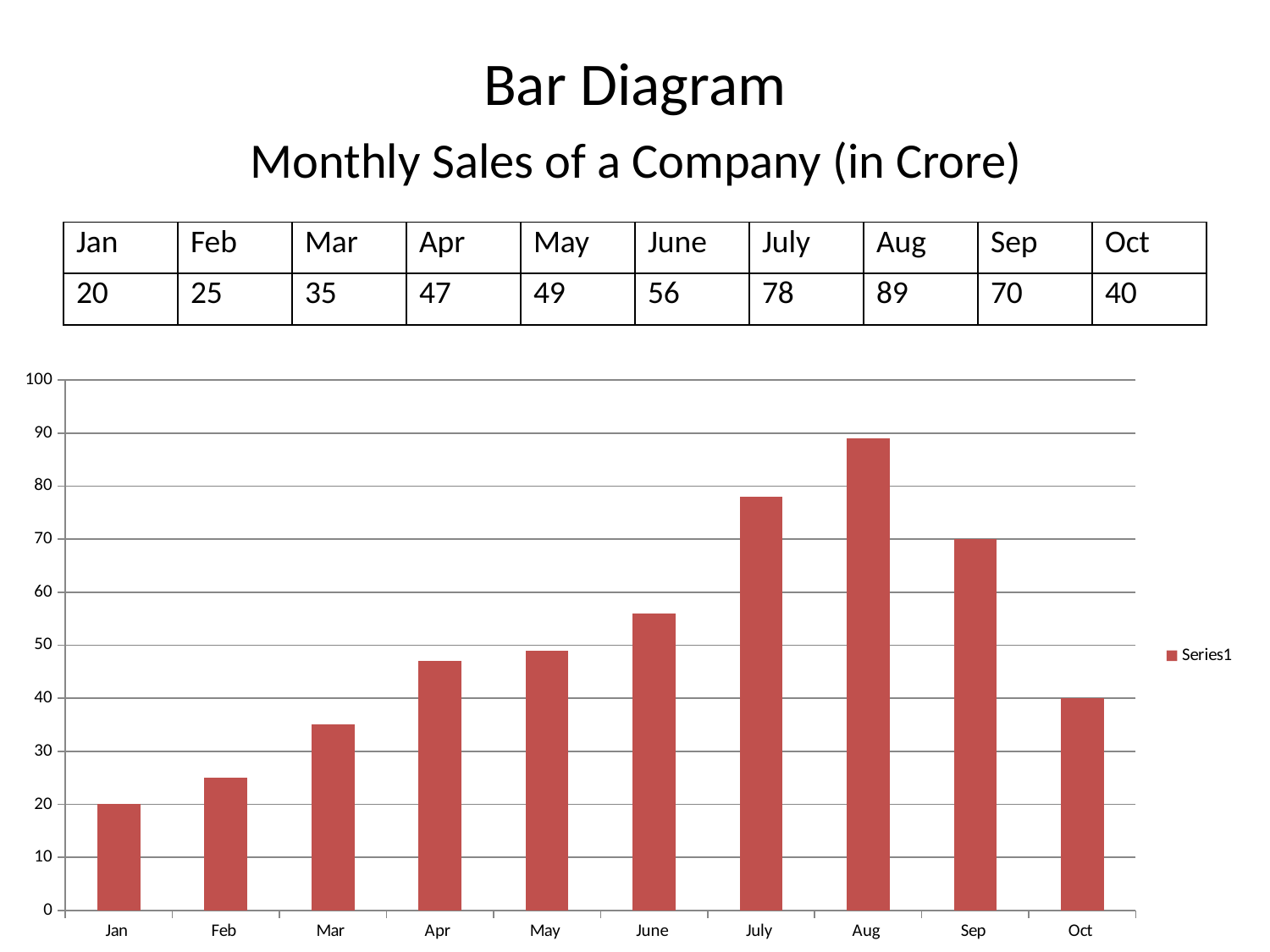
Is the value for July greater or less than 70? greater What is the sales value for Aug? 89 Which month has the lowest sales? Jan Which is larger, the sales for June or the sales for May? June What kind of chart is shown on the slide? bar chart How many months are shown on the x axis of the chart? 10 Do the sales values rise or fall from Jan to Aug? rise How many series does the legend list? 1 What is the difference between the sales for Aug and July? 11 What is the sales value for Apr? 47 What is the difference between the sales for Sep and Oct? 30 Which month has the highest sales? Aug